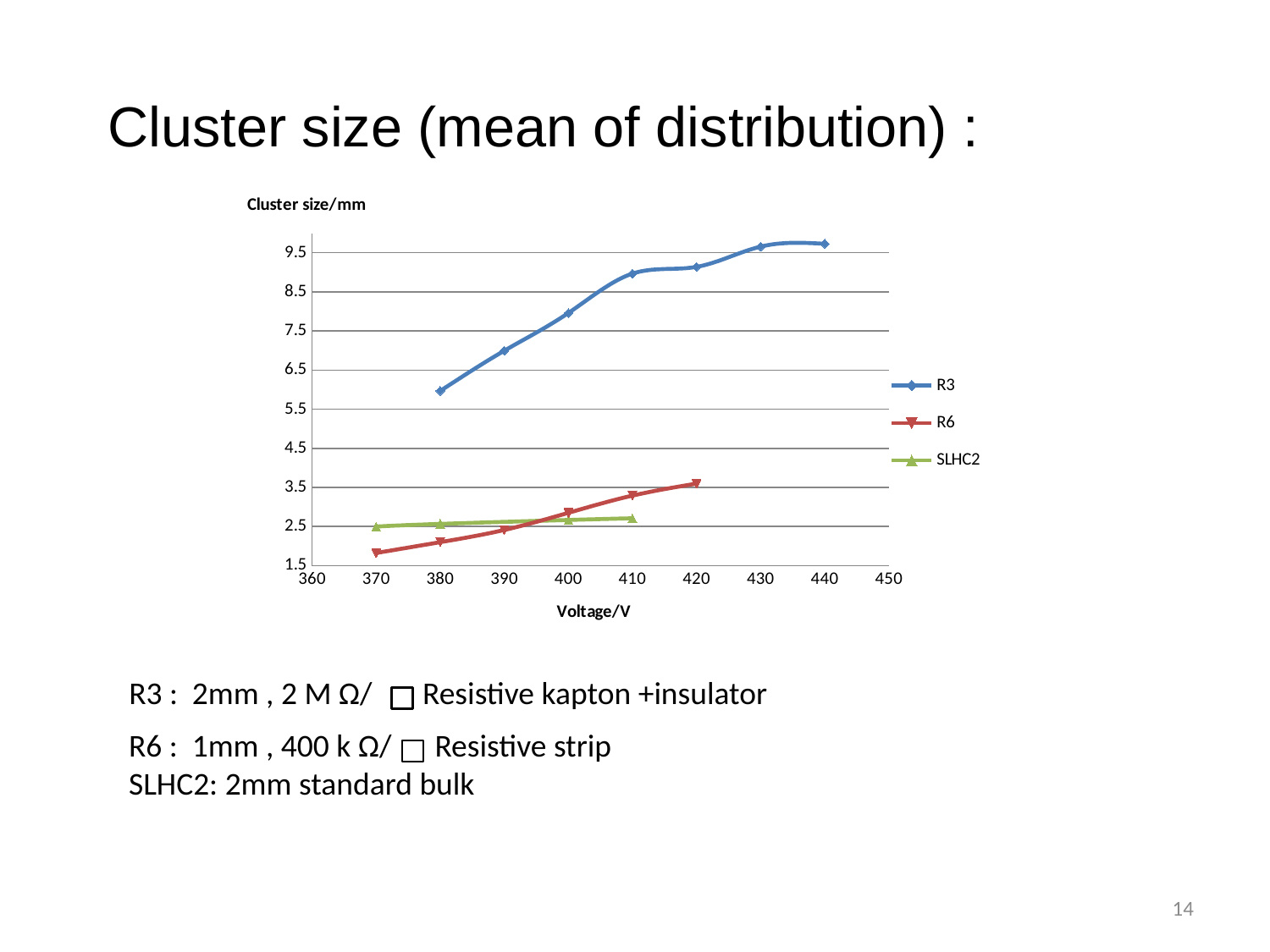
At 400 V, which series has the larger cluster size, R3 or R6? R3 What kind of chart is shown on the slide? line chart Is the cluster size for R6 at 410 V greater or less than 3.5? less What is the label of the x axis? Voltage/V Does the cluster size for R6 rise or fall as the voltage increases? rise Which series has the highest cluster size values on the chart? R3 Does the cluster size for R3 rise or fall as the voltage increases? rise Is the cluster size for R3 at 410 V greater or less than 8.5? greater How many series does the legend list? 3 Is the cluster size for R3 at 380 V greater or less than 5.5? greater Which series has the lowest cluster size at 370 V? R6